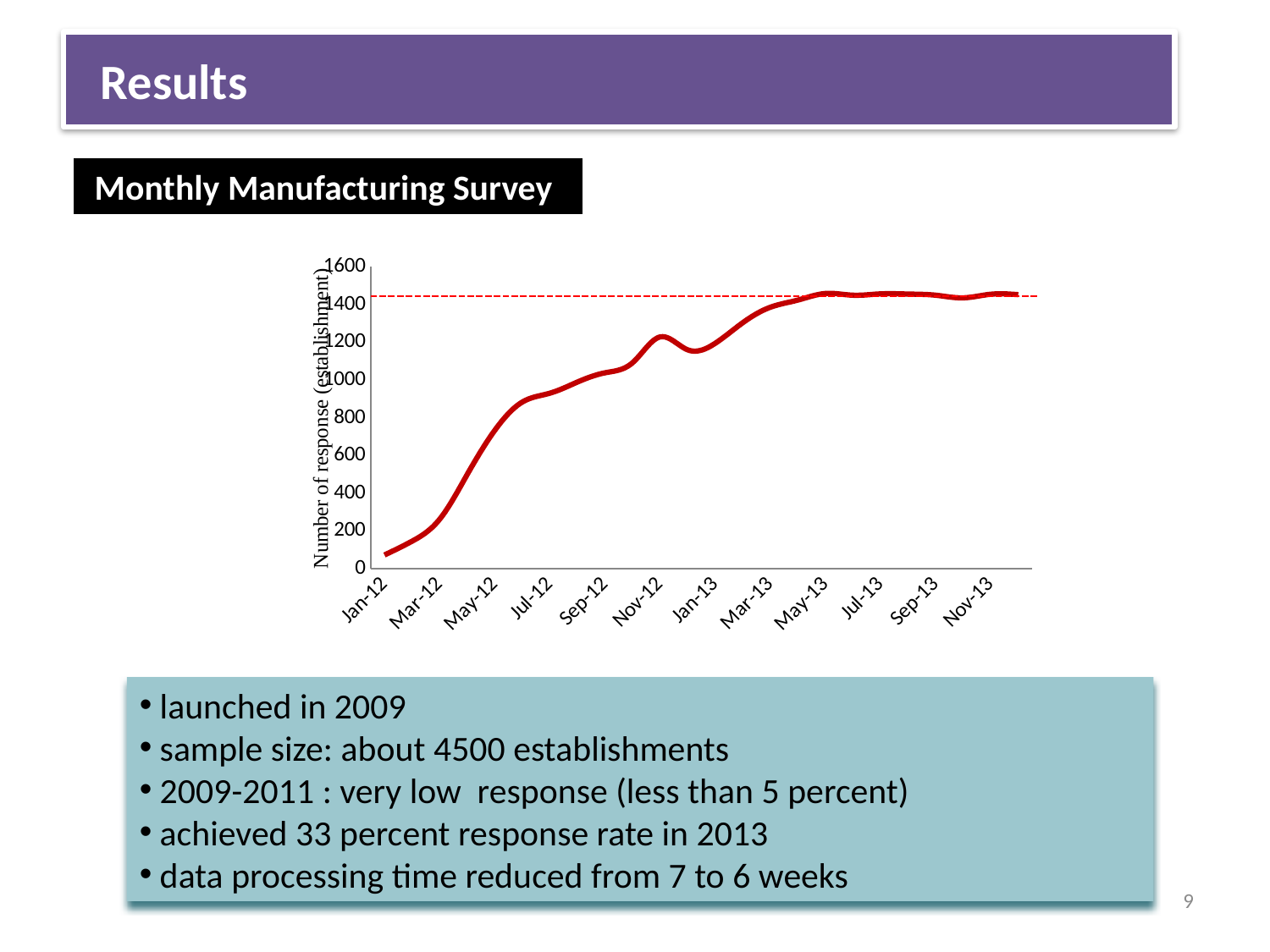
Is the value for Sep-12 greater or less than 1000? greater What kind of chart is shown on the slide? line chart Overall, do the values rise or fall from Jan-12 to Nov-13? rise Is the value for Jul-12 greater or less than 800? greater Is the value for Nov-13 greater or less than 1400? greater What is the highest value shown on the vertical axis of the chart? 1600 Which month on the x axis has the lowest number of responses? Jan-12 How many month labels are shown along the x axis of the chart? 12 What is the title of the vertical axis of the chart? Number of response (establishment) Which is larger, the value for Jul-12 or the value for Mar-13? Mar-13